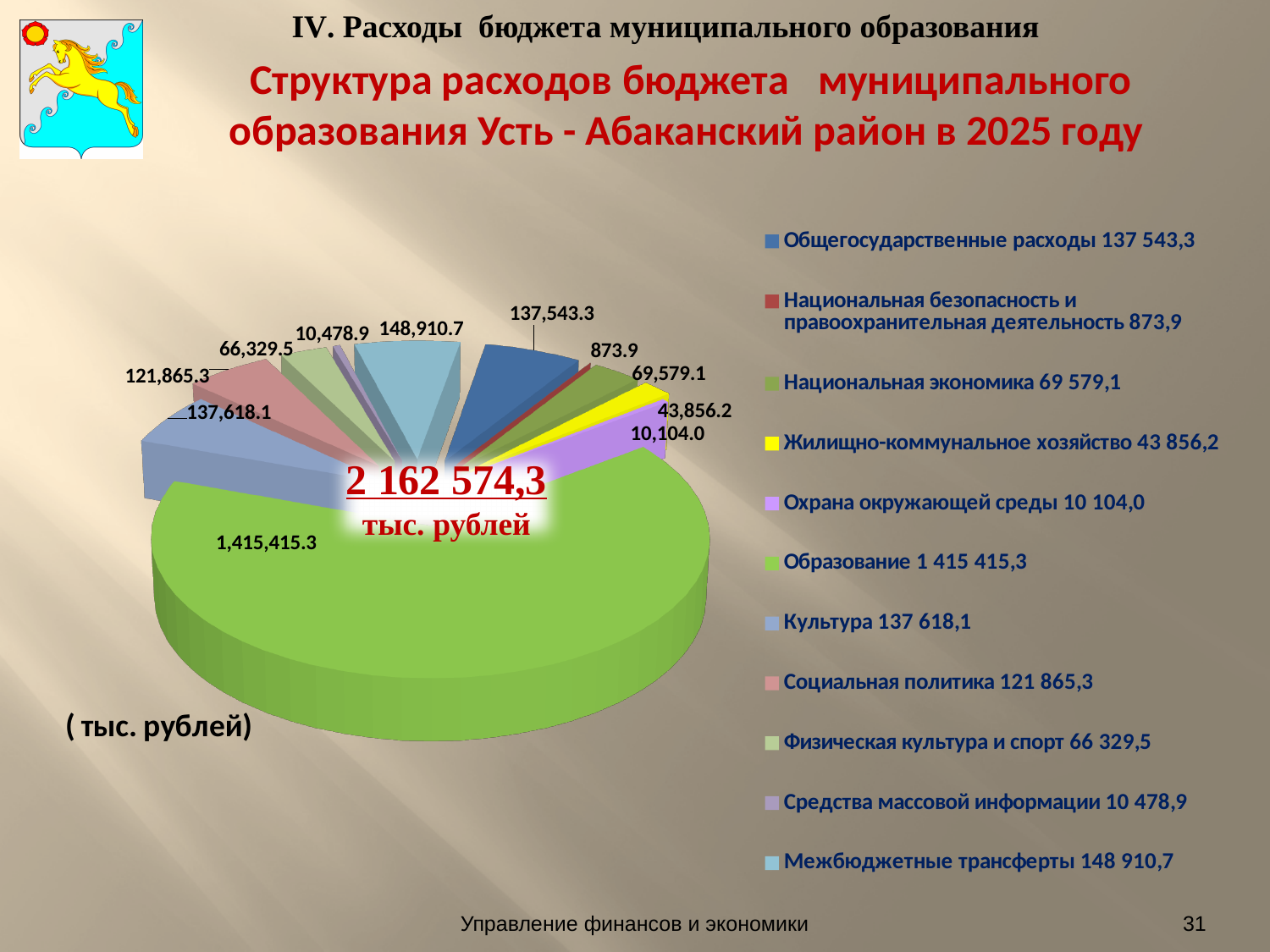
What unit is shown in the label at the bottom left of the chart? тыс. рублей Which category has the smallest slice of the pie? Национальная безопасность и правоохранительная деятельность What type of chart is shown on the slide? pie chart What total is printed in the centre of the pie chart? 2 162 574,3 тыс. рублей What is the value for Жилищно-коммунальное хозяйство? 43,856.2 What is the value for Межбюджетные трансферты? 148,910.7 What is the value for Национальная безопасность и правоохранительная деятельность? 873.9 What is the difference between the values for Межбюджетные трансферты and Культура? 11,292.6 What is the value for Образование? 1,415,415.3 Which is larger, the value for Социальная политика or the value for Физическая культура и спорт? Социальная политика How many categories does the pie chart have? 11 Which category has the largest slice of the pie? Образование